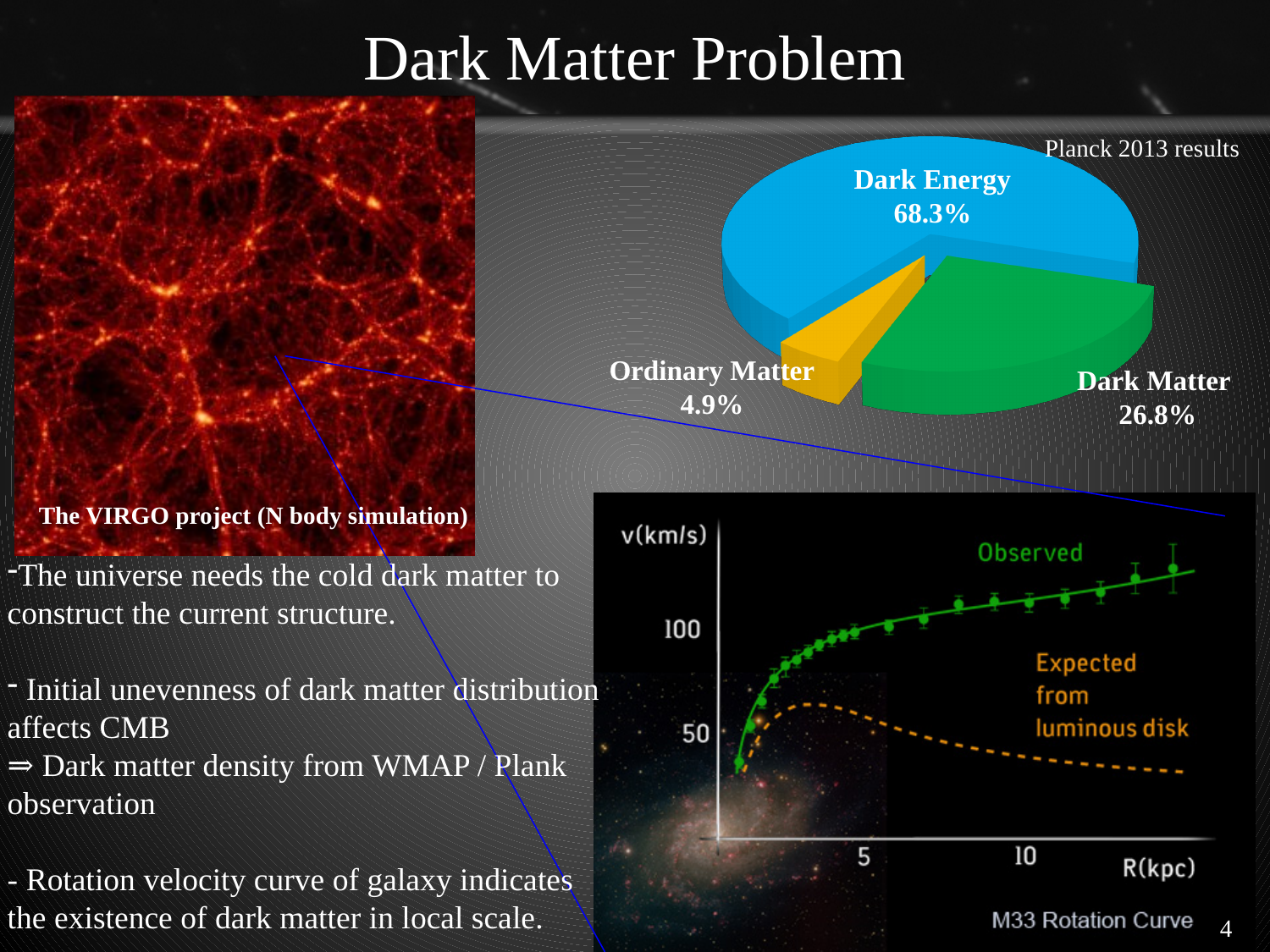
In the M33 Rotation Curve chart, is the Observed velocity at R = 10 kpc greater or less than 100 km/s? greater In the pie chart, what percentage is shown for Dark Energy? 68.3% In the pie chart, what percentage is shown for Dark Matter? 26.8% In the pie chart, which component has the largest share? Dark Energy In the M33 Rotation Curve chart, does the Observed velocity rise or fall as R increases? rise In the M33 Rotation Curve chart, what is the label of the dashed orange curve? Expected from luminous disk In the pie chart, what is the difference between the Dark Energy and Dark Matter percentages? 41.5% In the pie chart, which component has the smallest share? Ordinary Matter How many slices does the pie chart have? 3 In the pie chart, which is larger, Dark Matter or Ordinary Matter? Dark Matter In the pie chart, what percentage is shown for Ordinary Matter? 4.9% What kind of chart is the chart labelled 'Planck 2013 results'? Pie chart